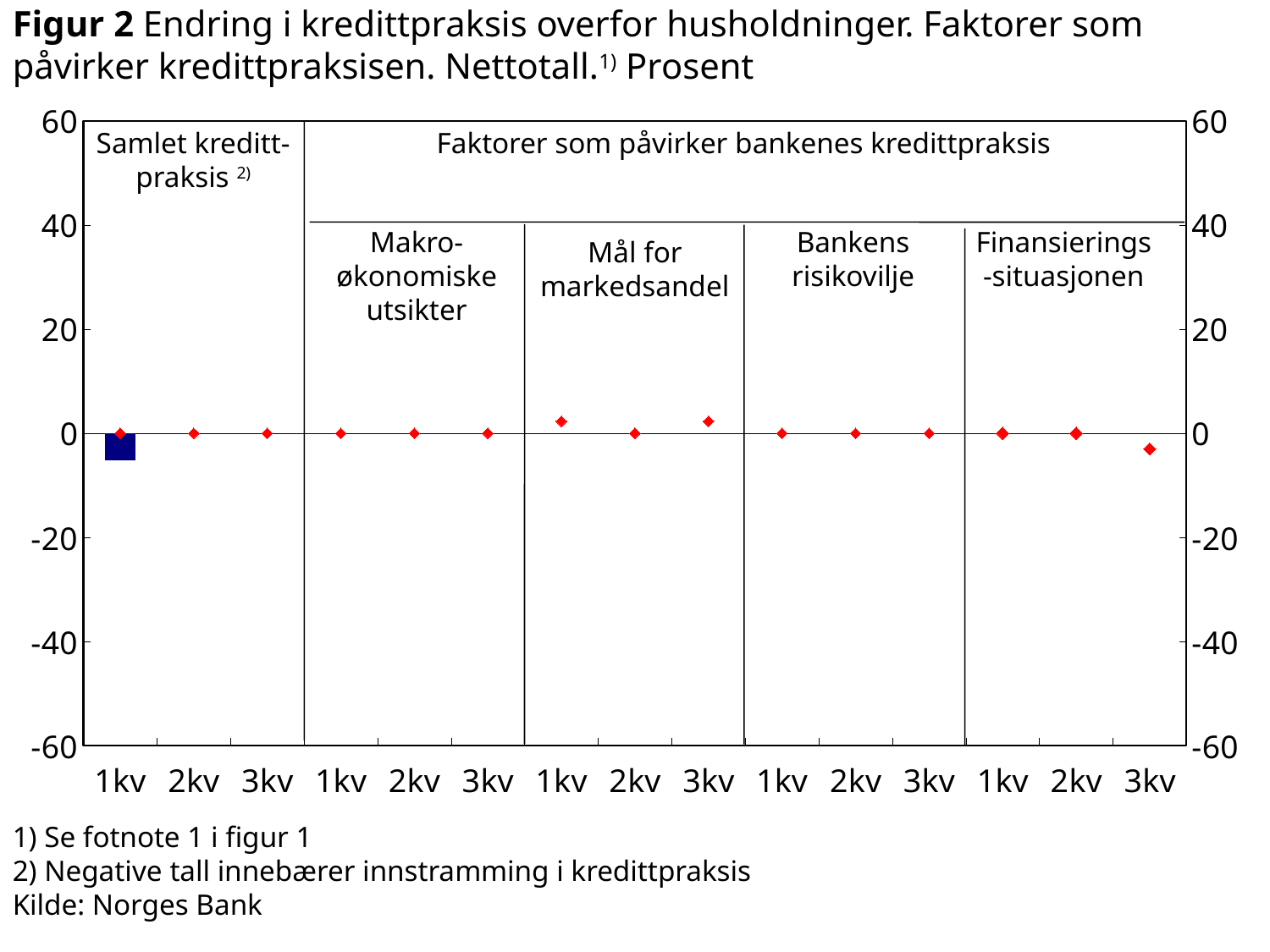
According to footnote 2, what do negative numbers indicate? Innstramming i kredittpraksis What kind of chart is shown on the slide? combination bar and line chart How many quarter categories are shown along the x axis in total? 15 Is the value for 1kv under 'Mål for markedsandel' greater or less than 20? less What is the value for 2kv under 'Samlet kredittpraksis'? 0 How many factor panels are listed under 'Faktorer som påvirker bankenes kredittpraksis'? 4 Is the value for 1kv under 'Samlet kredittpraksis' greater or less than -20? greater What is the source given for the chart? Norges Bank Is the value for 1kv under 'Samlet kredittpraksis' greater or less than 0? less What is the value for 2kv under 'Bankens risikovilje'? 0 Which is larger: the value for 1kv under 'Mål for markedsandel' or the value for 3kv under 'Finansieringssituasjonen'? 1kv under Mål for markedsandel